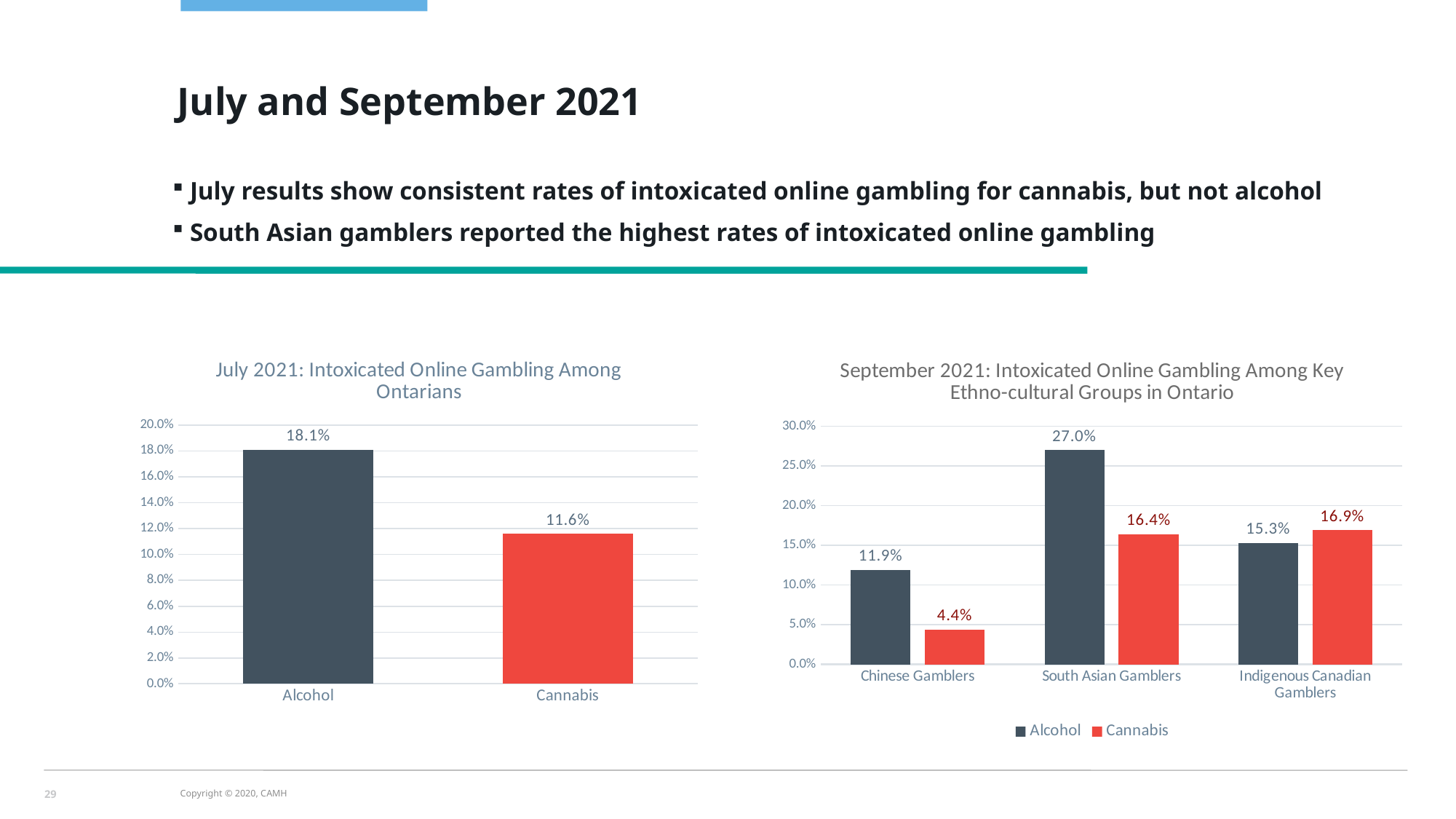
In the September 2021 chart, which group has the highest Alcohol value? South Asian Gamblers In the September 2021 chart, what is the Alcohol value for South Asian Gamblers? 27.0% In the July 2021 chart, what is the difference between the Alcohol and Cannabis values? 6.5% In the July 2021 chart, what is the value for Alcohol? 18.1% In the September 2021 chart, what is the Cannabis value for Chinese Gamblers? 4.4% In the July 2021 chart, how many categories are shown? 2 In the July 2021 chart, what is the value for Cannabis? 11.6% What type of chart is the September 2021 chart? Bar chart In the September 2021 chart, what is the difference between the Alcohol and Cannabis values for South Asian Gamblers? 10.6% In the September 2021 chart, for Indigenous Canadian Gamblers, which is larger: the Alcohol value or the Cannabis value? Cannabis In the September 2021 chart, which group has the lowest Cannabis value? Chinese Gamblers How many series does the legend of the September 2021 chart list? 2